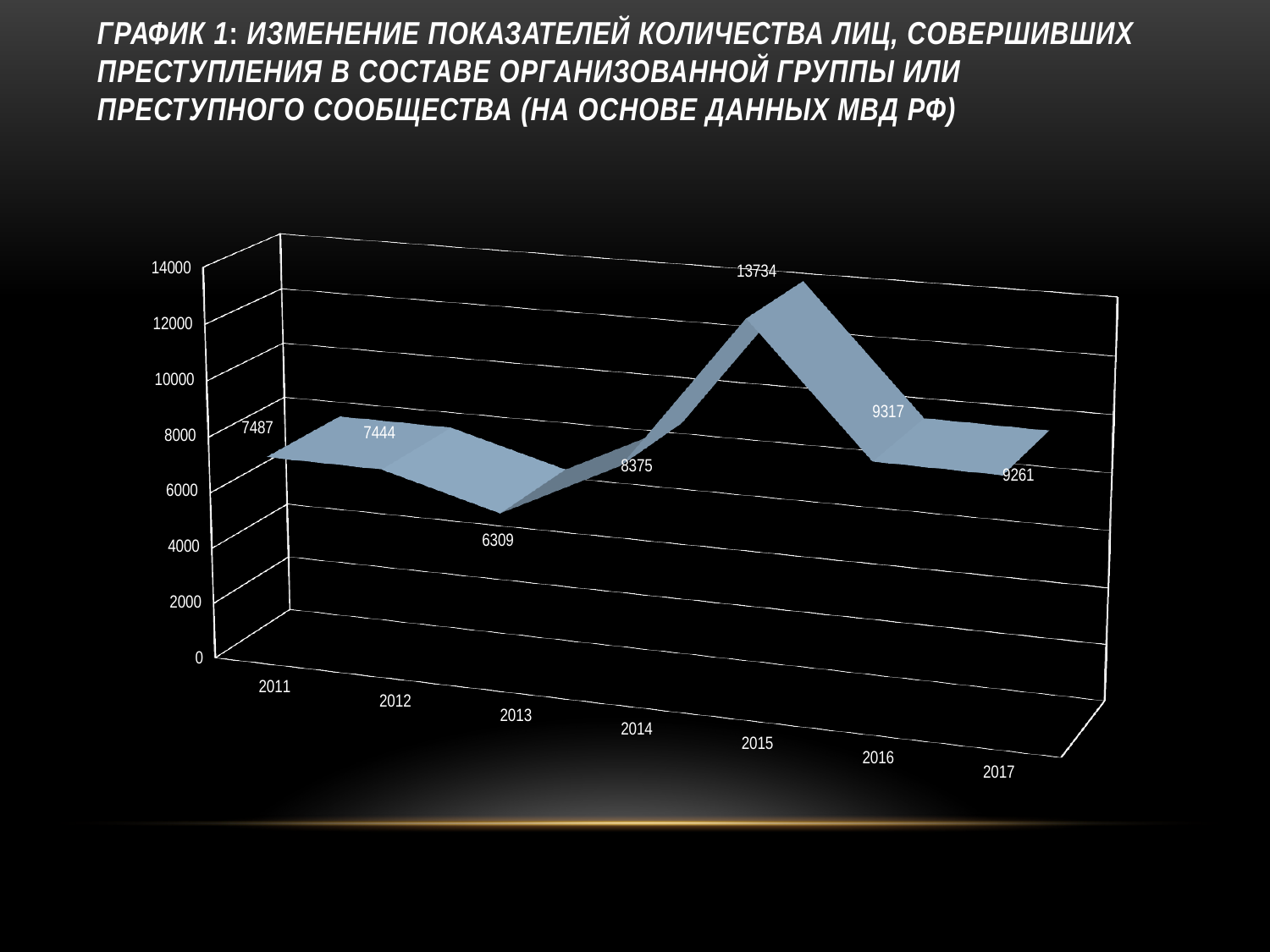
What is the value for 2013? 6309 What is the difference between the values for 2014 and 2013? 2066 Which year has the lowest value? 2013 What is the value for 2017? 9261 Do the values rise or fall from 2013 to 2015? rise Which is larger, the value for 2014 or the value for 2012? 2014 How many years are plotted on the chart? 7 What kind of chart is shown on the slide? line chart Which year has the highest value? 2015 What is the value for 2011? 7487 What is the value for 2015? 13734 What is the difference between the values for 2015 and 2016? 4417